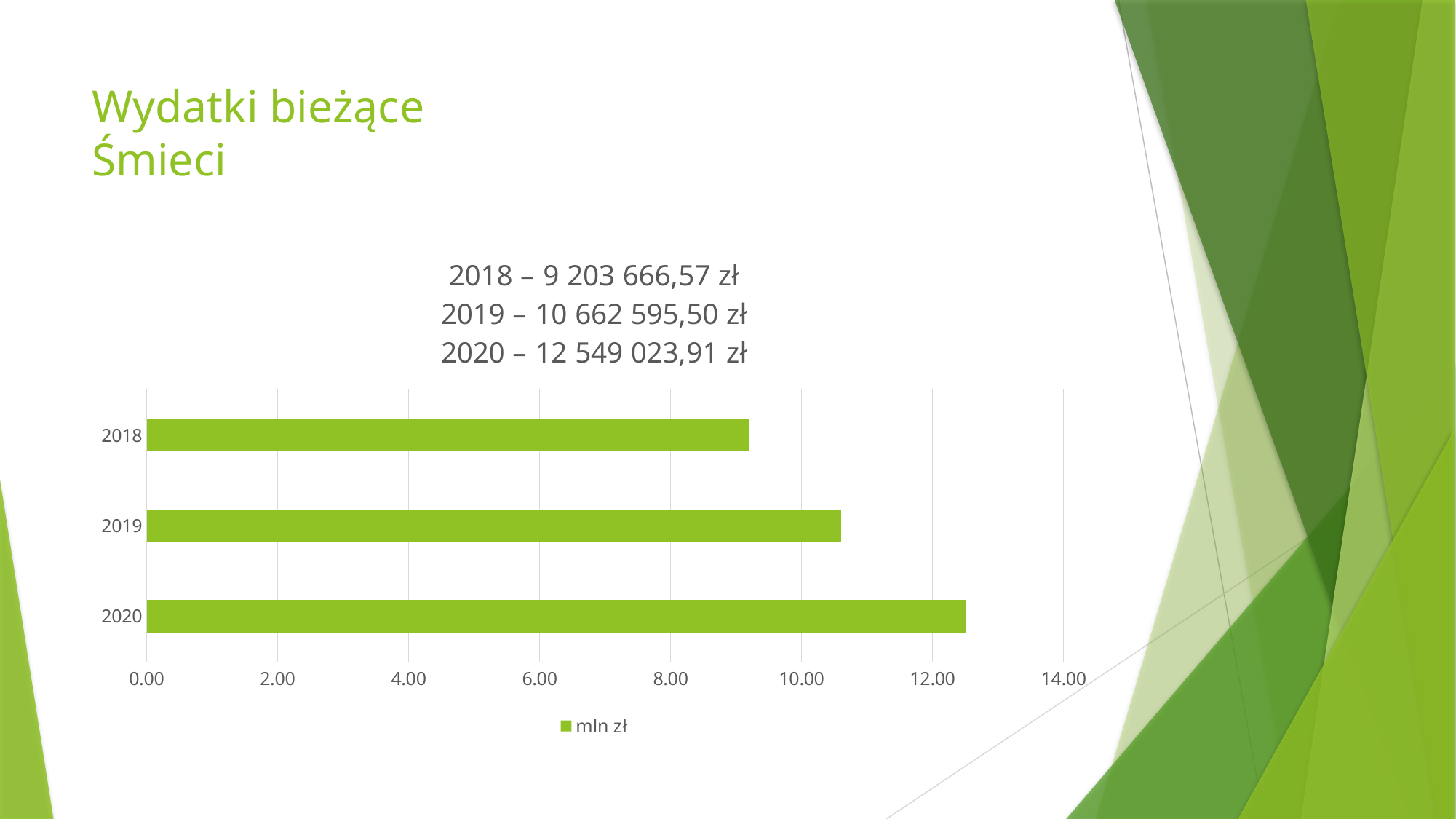
What kind of chart is shown on the slide? bar chart What is the legend entry of the chart? mln zł How many years (categories) are plotted in the chart? 3 Is the value for 2020 greater or less than 12.00? greater Which year has the lowest expenditure in the chart? 2018 How many series does the chart legend list? 1 Is the value for 2018 greater or less than 10.00? less By how much did the expenditure increase from 2019 to 2020, based on the values printed on the slide? 1 886 428,41 zł According to the slide, what was the expenditure for 2020? 12 549 023,91 zł Which year has the highest expenditure in the chart? 2020 According to the slide, what was the expenditure for 2018? 9 203 666,57 zł Do the values rise or fall from 2018 to 2020? rise